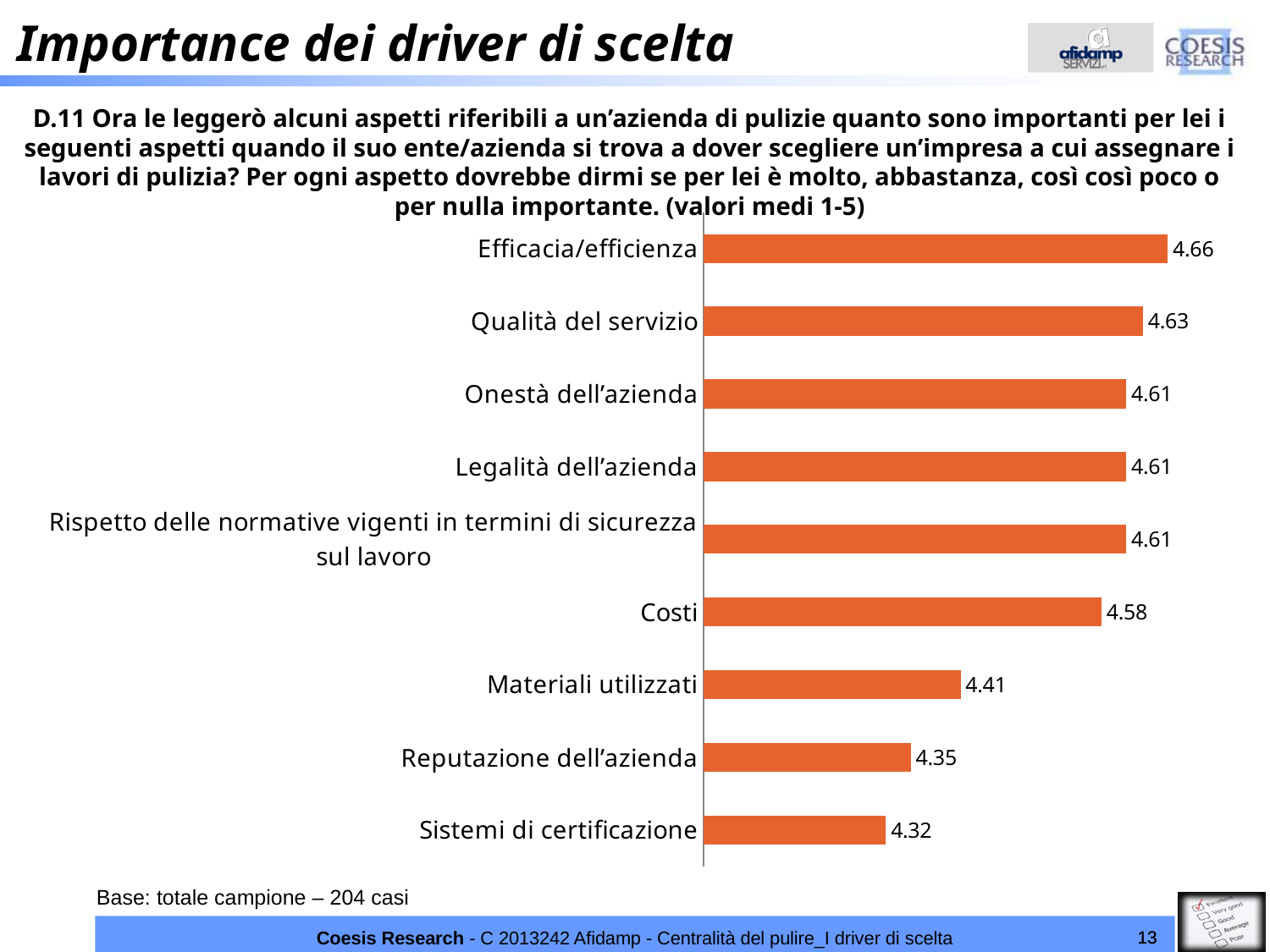
What is the value for Qualità del servizio? 4.63 Which category has the lowest value? Sistemi di certificazione Which has a larger value, Reputazione dell'azienda or Materiali utilizzati? Materiali utilizzati What is the value for Sistemi di certificazione? 4.32 Which category has the highest value? Efficacia/efficienza What is the value for Costi? 4.58 What is the value for Efficacia/efficienza? 4.66 How many categories are shown in the chart? 9 What is the difference between the values for Efficacia/efficienza and Sistemi di certificazione? 0.34 What is the difference between the values for Costi and Materiali utilizzati? 0.17 What is the value for Materiali utilizzati? 4.41 What kind of chart is shown on the slide? Bar chart